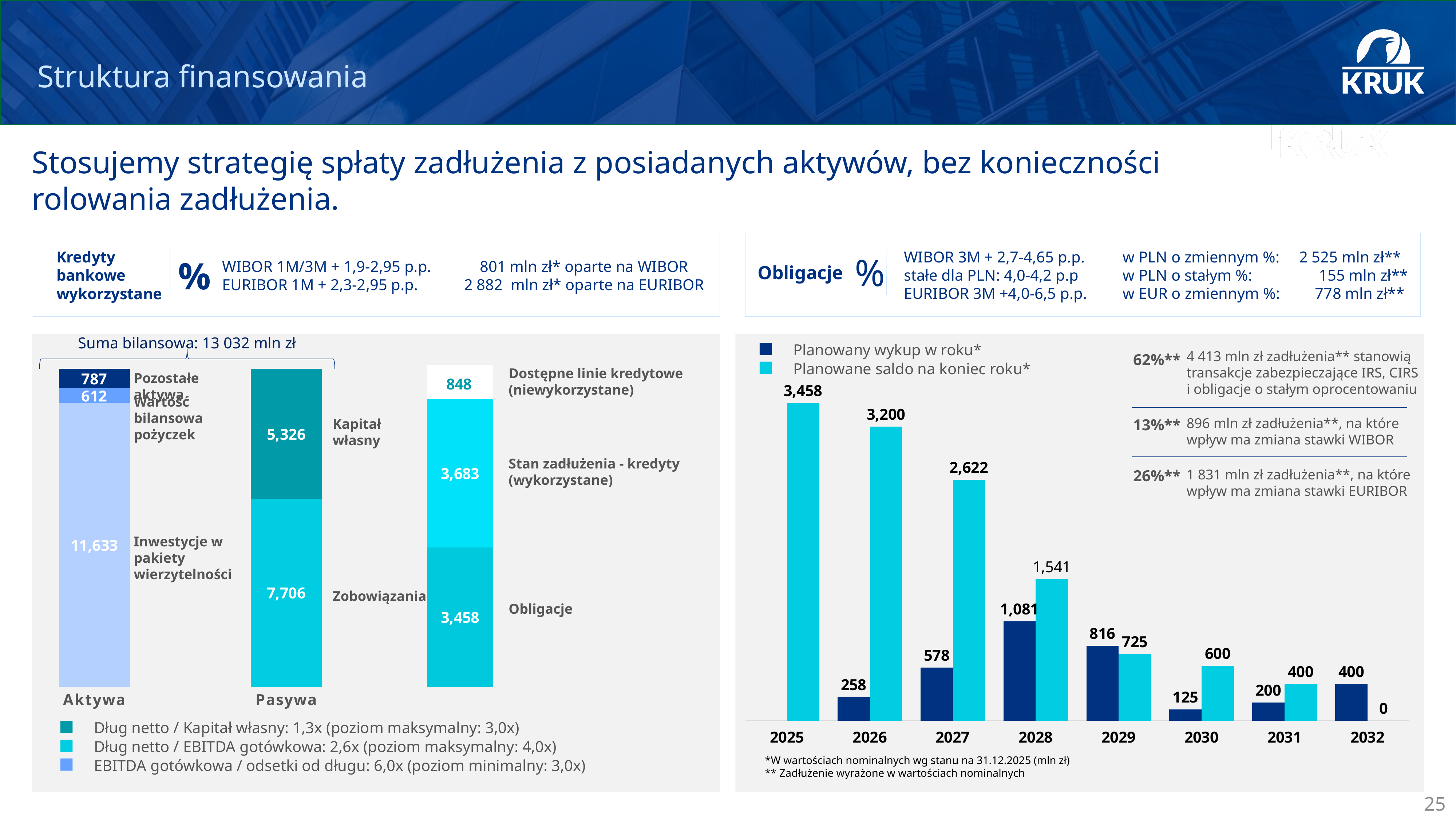
What kind of chart is the right-hand chart showing planned redemptions by year? bar chart In the right-hand chart, how many years are shown on the x axis? 8 In the right-hand chart, which year has the lowest planned redemption (Planowany wykup w roku) among 2026–2032? 2030 In the right-hand chart of planned bond redemptions, what is the planned year-end balance (Planowane saldo na koniec roku) for 2027? 2,622 In the right-hand chart, is the planned redemption for 2029 larger or smaller than the planned year-end balance for 2029? larger In the left-hand chart, what is the total of the Pasywa bar (Kapitał własny plus Zobowiązania)? 13,032 In the left-hand chart, what is the value of the Kapitał własny segment of the Pasywa bar? 5,326 In the right-hand chart, what is the difference between the planned year-end balance for 2025 and for 2026? 258 In the right-hand chart, which year has the highest planned redemption (Planowany wykup w roku)? 2028 In the right-hand chart, what is the planned redemption (Planowany wykup w roku) for 2028? 1,081 In the right-hand chart, does the planned year-end balance (Planowane saldo na koniec roku) rise or fall from 2025 to 2032? fall In the right-hand chart, how many series does the legend list? 2